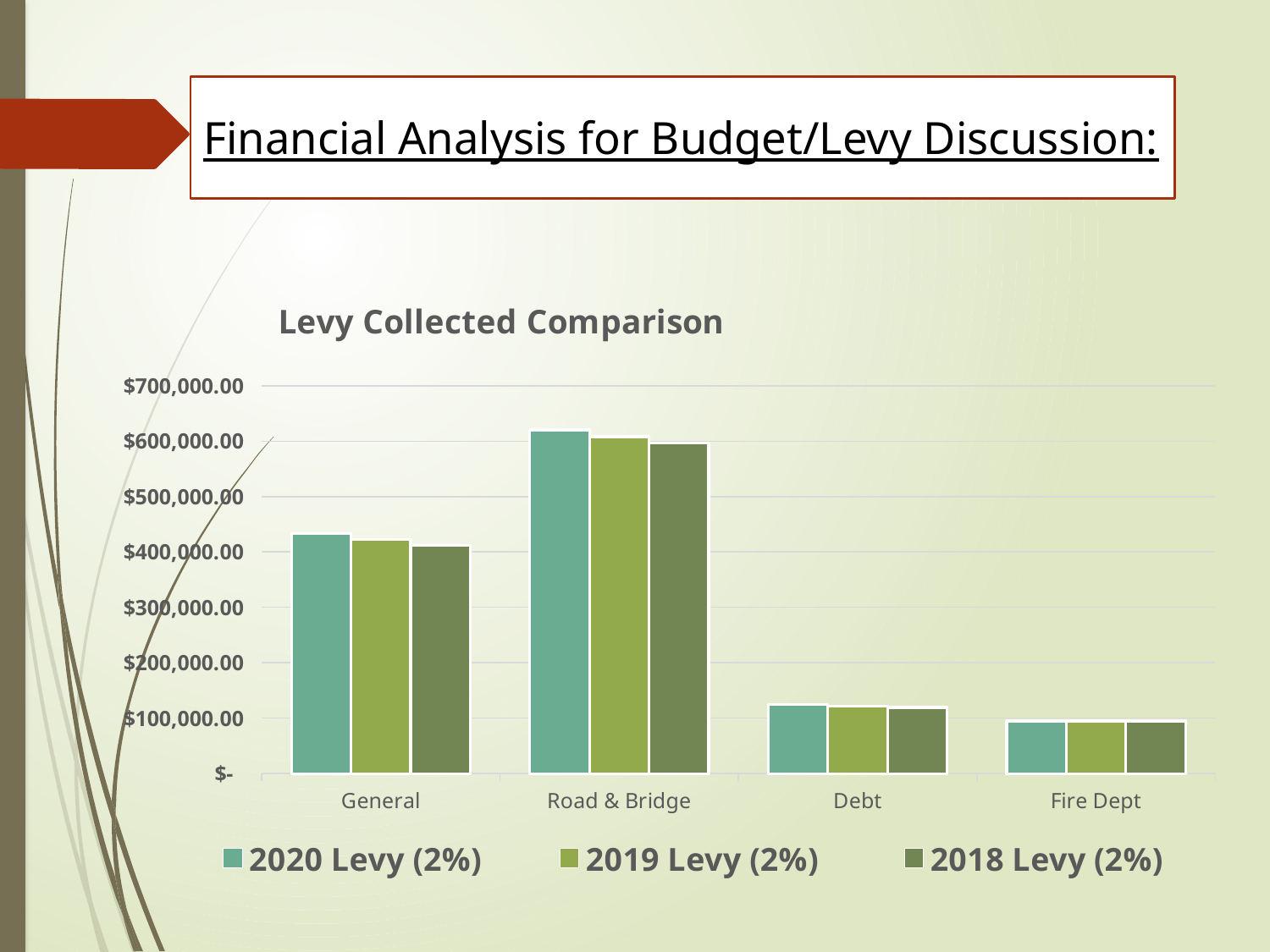
Is the 2020 Levy (2%) value for Road & Bridge greater or less than $500,000.00? greater How many categories are shown on the x axis of the chart? 4 What is the title of the chart? Levy Collected Comparison Is the 2020 Levy (2%) value for Debt greater or less than $100,000.00? greater What kind of chart is shown on the slide? Bar chart Which series is listed first in the chart's legend? 2020 Levy (2%) Is the 2020 Levy (2%) value for Fire Dept greater or less than $100,000.00? less For the 2020 Levy (2%) series, which is larger: Road & Bridge or General? Road & Bridge Which category has the highest levy collected for the 2020 Levy (2%) series? Road & Bridge How many series does the chart's legend list? 3 Which category has the lowest levy collected for the 2020 Levy (2%) series? Fire Dept